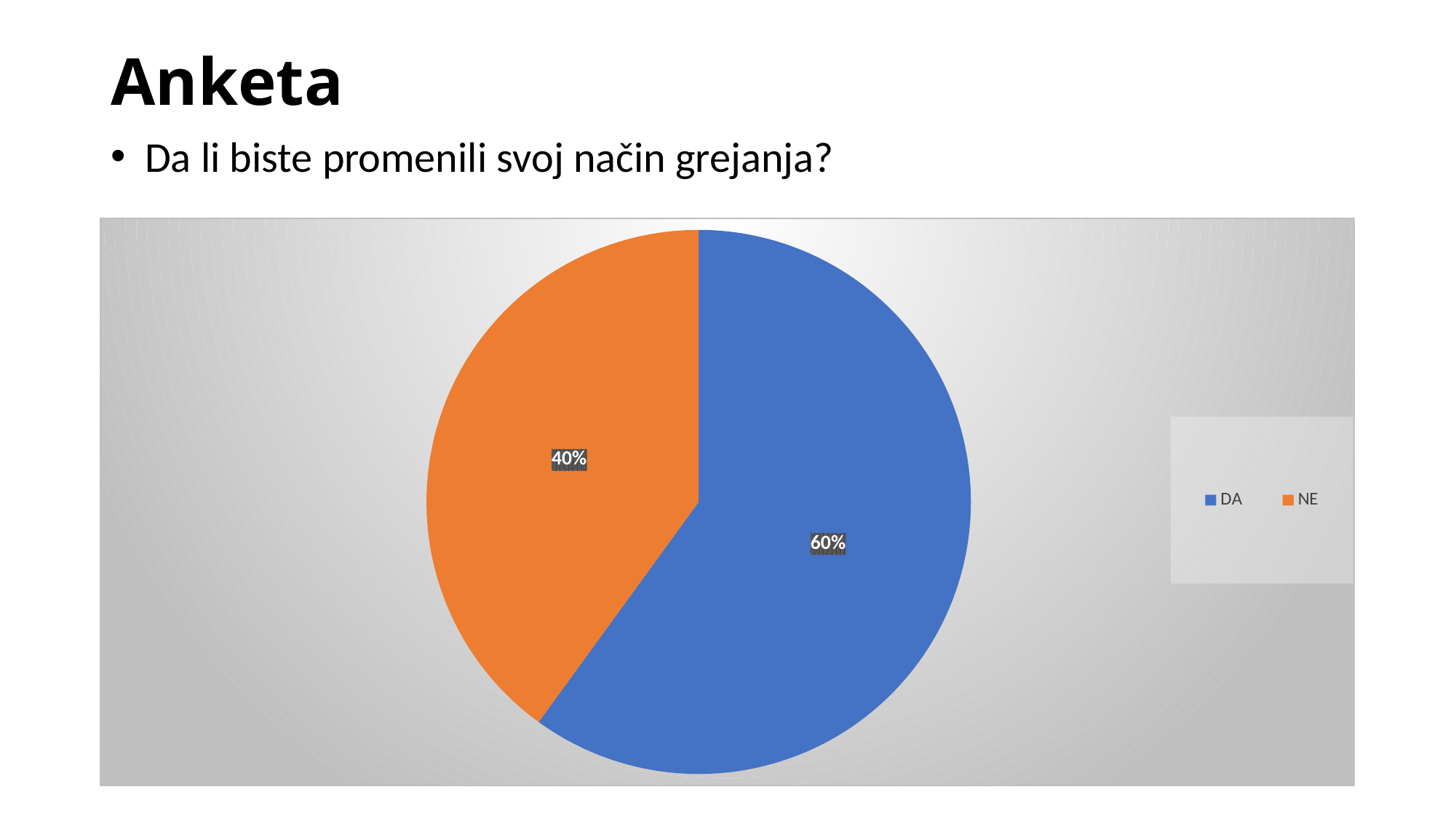
What share of the pie does NE represent? 40% What colour is the NE slice? orange How many entries does the legend list? 2 Is the share for DA greater or less than 50%? greater How many slices does the pie chart have? 2 What kind of chart is shown on the slide? pie chart Which slice is the smallest? NE Which is larger, DA or NE? DA Which slice is the largest? DA What is the difference in percentage points between DA and NE? 20 percentage points What colour is the DA slice? blue What share of the pie does DA represent? 60%